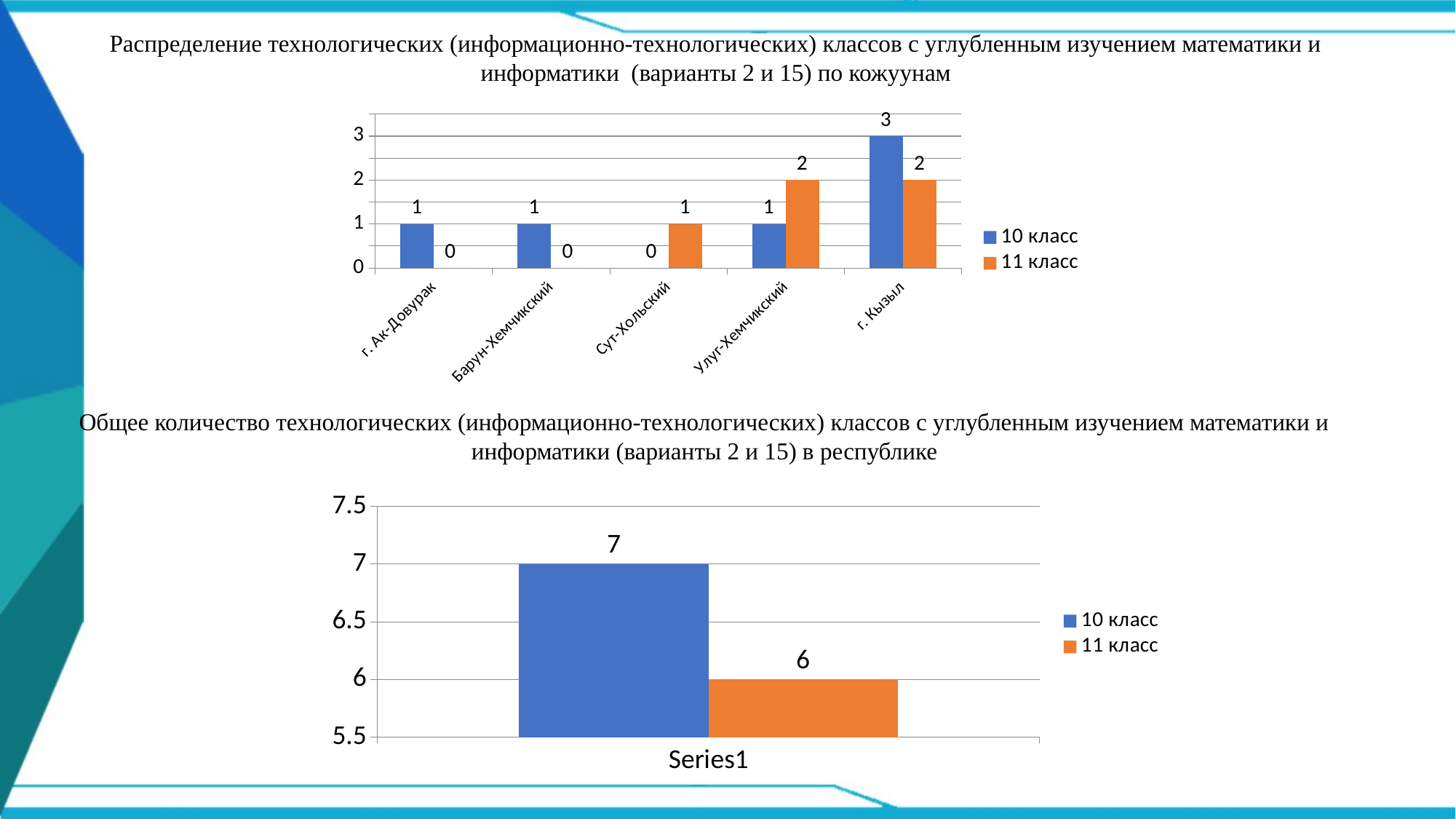
In the top chart (distribution by kozhuun), which is larger in Улуг-Хемчикский: 10 класс or 11 класс? 11 класс What kind of chart is the bottom chart (total in the republic)? Bar chart In the top chart (distribution by kozhuun), which category has the highest value for 10 класс? г. Кызыл In the top chart (distribution by kozhuun), what is the value for 11 класс in Сут-Хольский? 1 In the top chart (distribution by kozhuun), how many series does the legend list? 2 In the top chart (distribution by kozhuun), what is the value for 11 класс in Улуг-Хемчикский? 2 In the bottom chart (total in the republic), what is the value for 11 класс? 6 In the bottom chart (total in the republic), what is the value for 10 класс? 7 In the bottom chart (total in the republic), what is the difference between the 10 класс and 11 класс values? 1 In the top chart (distribution by kozhuun), what is the value for 10 класс in г. Кызыл? 3 In the top chart (distribution by kozhuun), how many categories are shown on the x axis? 5 In the top chart (distribution by kozhuun), what is the difference between the 10 класс and 11 класс values in г. Кызыл? 1